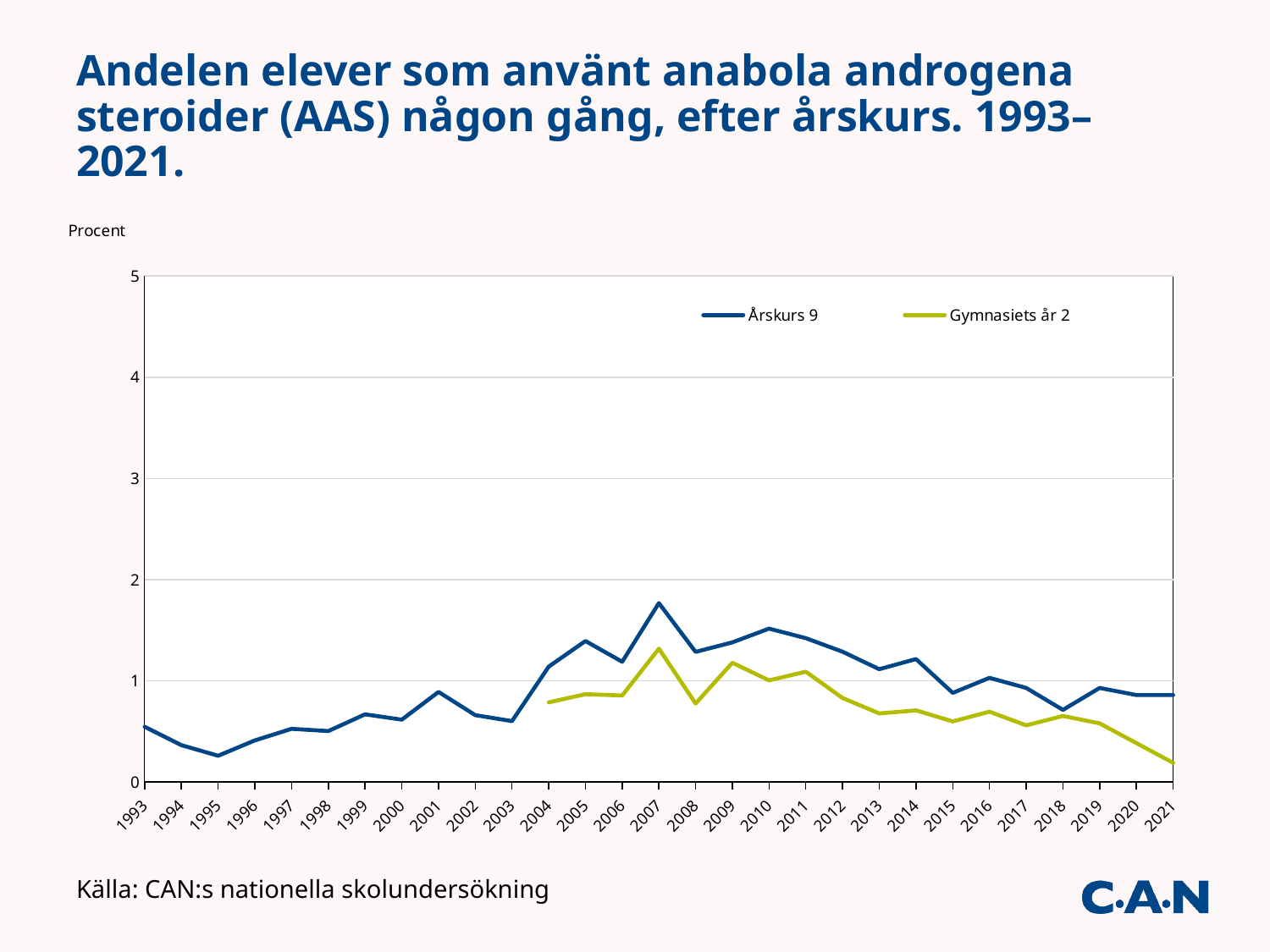
In which year is the Gymnasiets år 2 series at its lowest? 2021 In 2007, which series has the larger value, Årskurs 9 or Gymnasiets år 2? Årskurs 9 Does the Gymnasiets år 2 series rise or fall between 2007 and 2021? Fall What kind of chart is shown on the slide? Line chart In which year does the Årskurs 9 series reach its highest value? 2007 What unit label is shown above the y axis? Procent In which year does the Gymnasiets år 2 series reach its highest value? 2007 In which year is the Årskurs 9 series at its lowest? 1995 Is the value for Årskurs 9 in 2007 greater or less than 1? greater How many series does the legend list? 2 Is the value for Gymnasiets år 2 in 2021 greater or less than 1? less How many years are shown on the x axis? 29